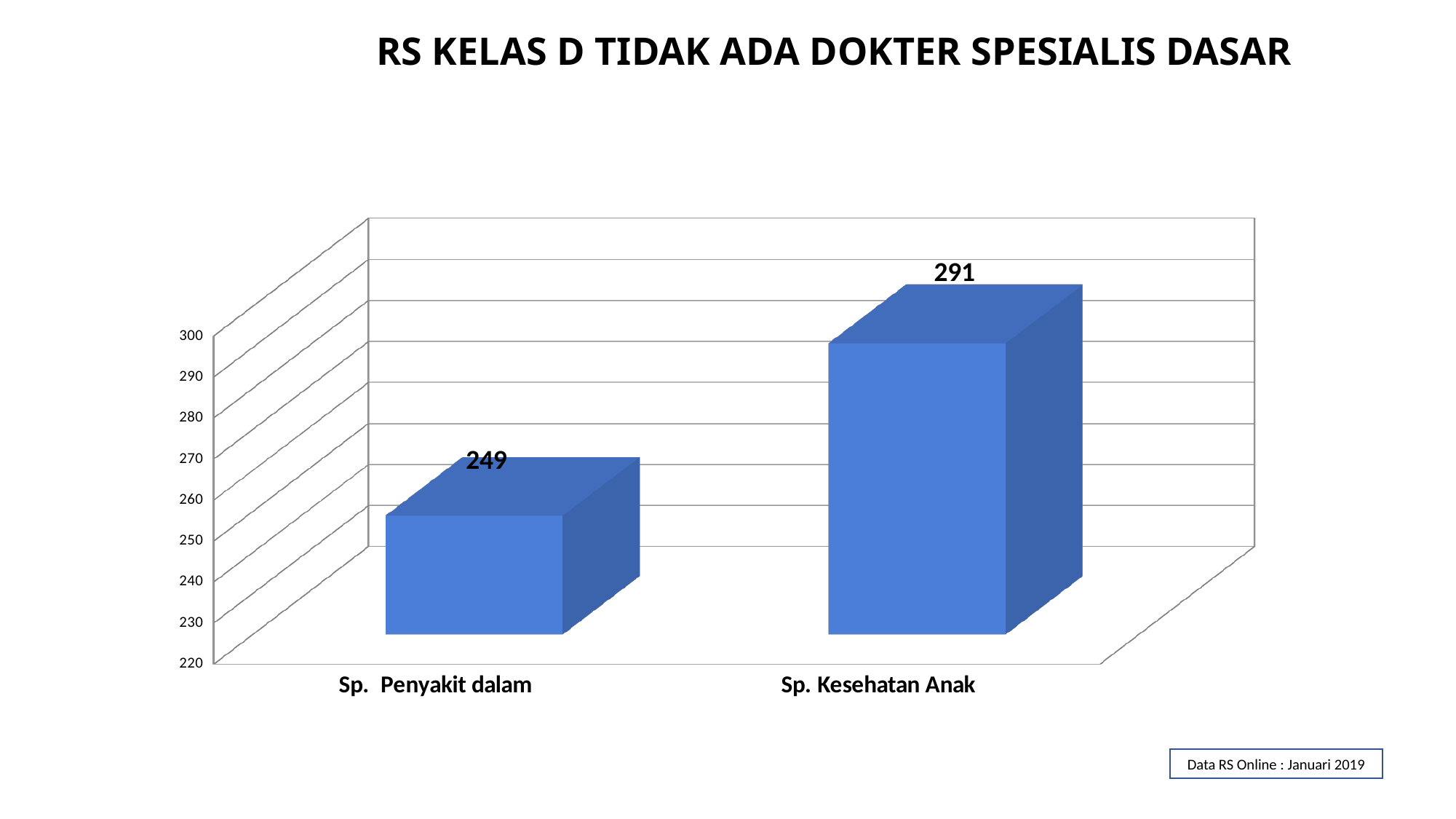
Which is larger, the value for Sp. Penyakit dalam or the value for Sp. Kesehatan Anak? Sp. Kesehatan Anak Is the value for Sp. Kesehatan Anak greater or less than 280? greater What data source is cited on the slide? Data RS Online : Januari 2019 Is the value for Sp. Penyakit dalam greater or less than 260? less What kind of chart is shown on the slide? Bar chart What is the difference between the values for Sp. Kesehatan Anak and Sp. Penyakit dalam? 42 What is the value for Sp. Kesehatan Anak? 291 How many categories are shown in the chart? 2 Which category has the highest value? Sp. Kesehatan Anak What is the value for Sp. Penyakit dalam? 249 Which category has the lowest value? Sp. Penyakit dalam What is the title of the chart? RS KELAS D TIDAK ADA DOKTER SPESIALIS DASAR